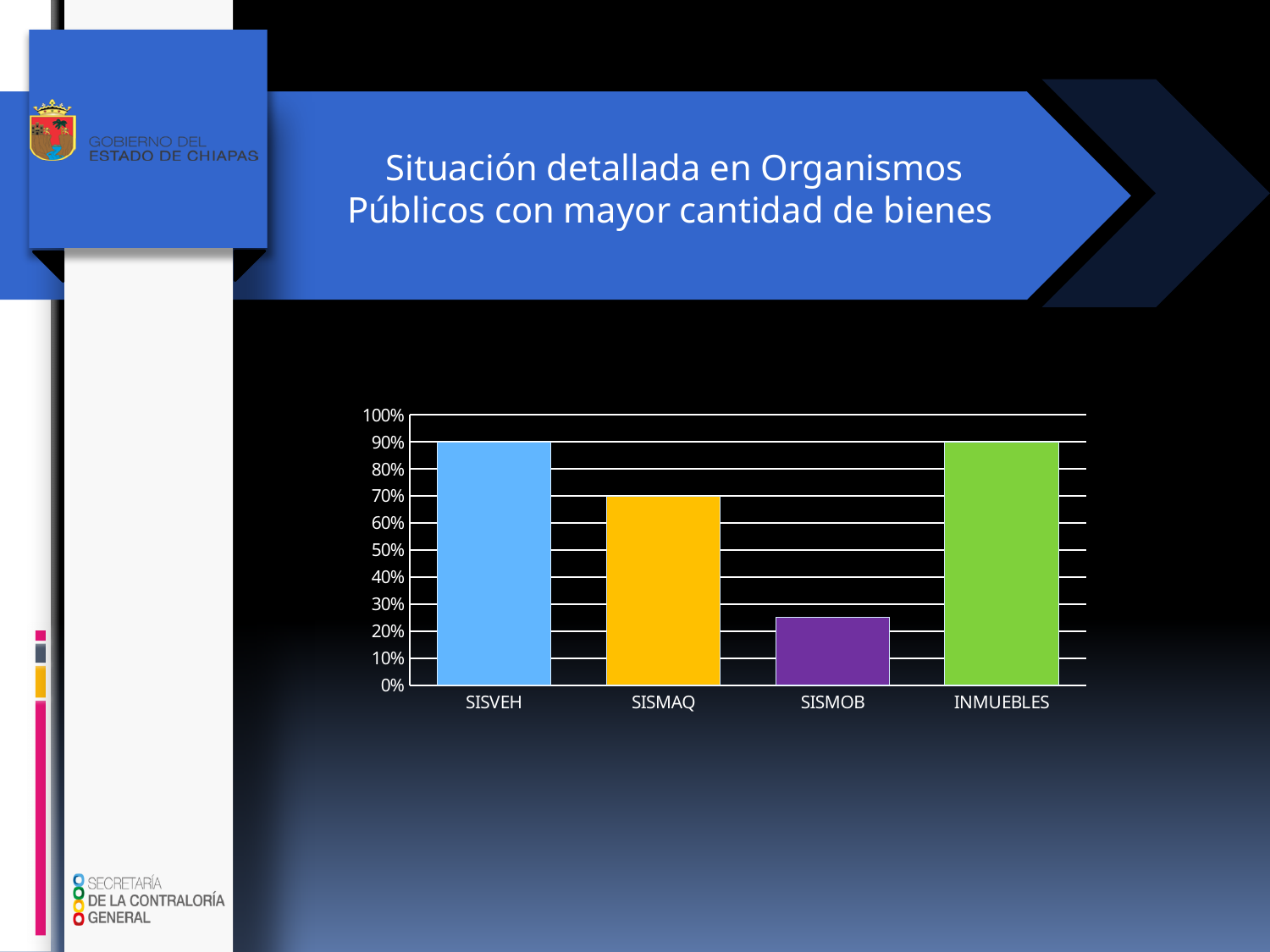
Is the value for SISMOB greater or less than 30%? less What kind of chart is shown on the slide? bar chart What is the value for INMUEBLES? 90% Which is larger, the value for SISVEH or the value for SISMAQ? SISVEH What is the value for SISVEH? 90% How many categories are shown on the x axis? 4 Which is larger, the value for SISMOB or the value for INMUEBLES? INMUEBLES What colour is the bar for SISMAQ? yellow What is the value for SISMAQ? 70% Is the value for SISMOB greater or less than 20%? greater What is the difference between the values for SISVEH and SISMAQ? 20% Which category has the lowest value? SISMOB